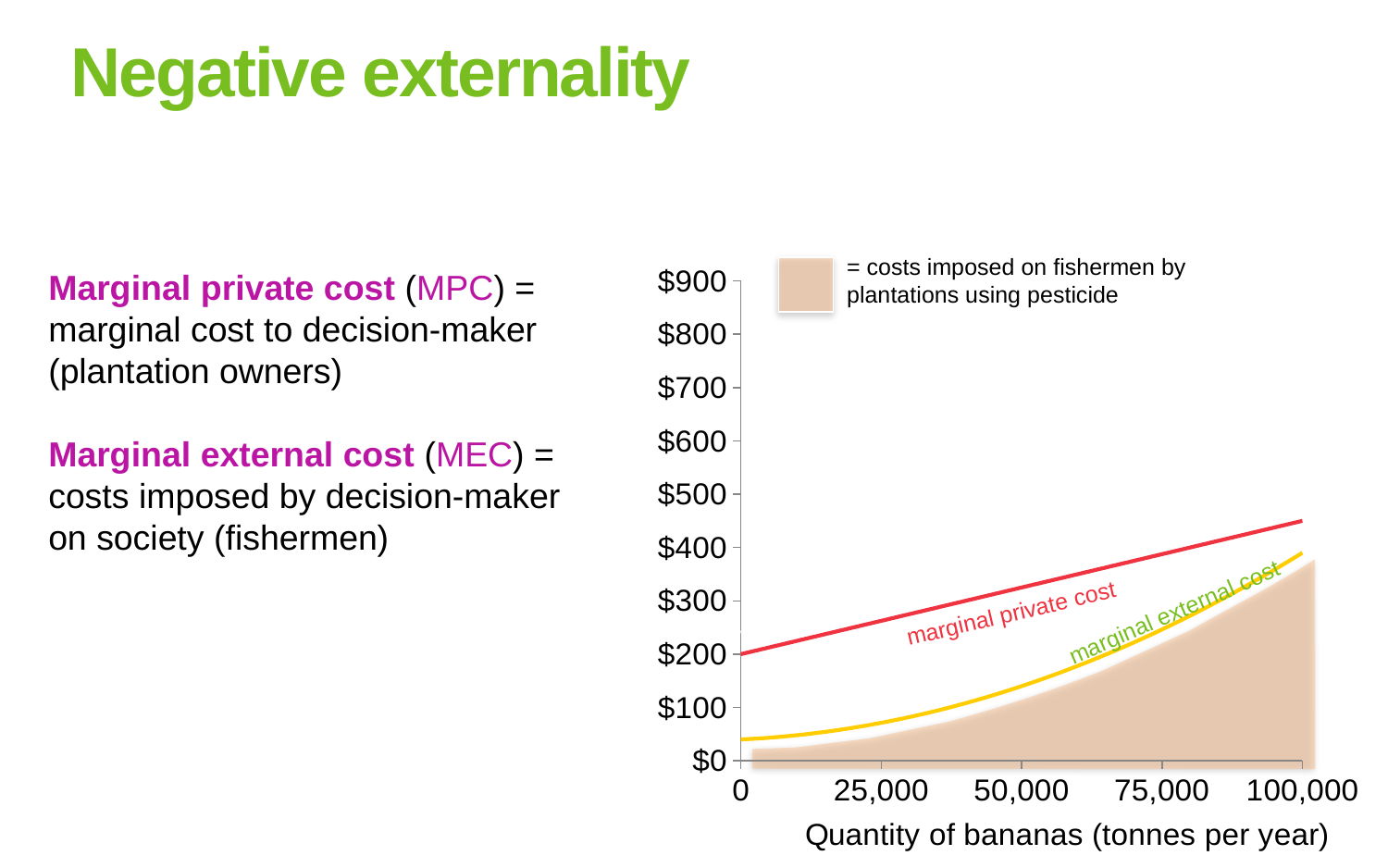
At 0 tonnes per year, is the marginal external cost greater or less than $100? less At 100,000 tonnes per year, which is higher: marginal private cost or marginal external cost? marginal private cost At 100,000 tonnes per year, is the marginal private cost greater or less than $400? greater Does the marginal external cost line rise or fall as the quantity of bananas increases? rise According to the legend, what does the shaded area under the marginal external cost line represent? costs imposed on fishermen by plantations using pesticide At 100,000 tonnes per year, is the marginal external cost greater or less than $300? greater What kind of chart is shown on the slide? line chart Does the marginal private cost line rise or fall as the quantity of bananas increases? rise How many lines are plotted on the chart? 2 What is the label of the x axis? Quantity of bananas (tonnes per year) How many labelled tick marks are on the x axis? 5